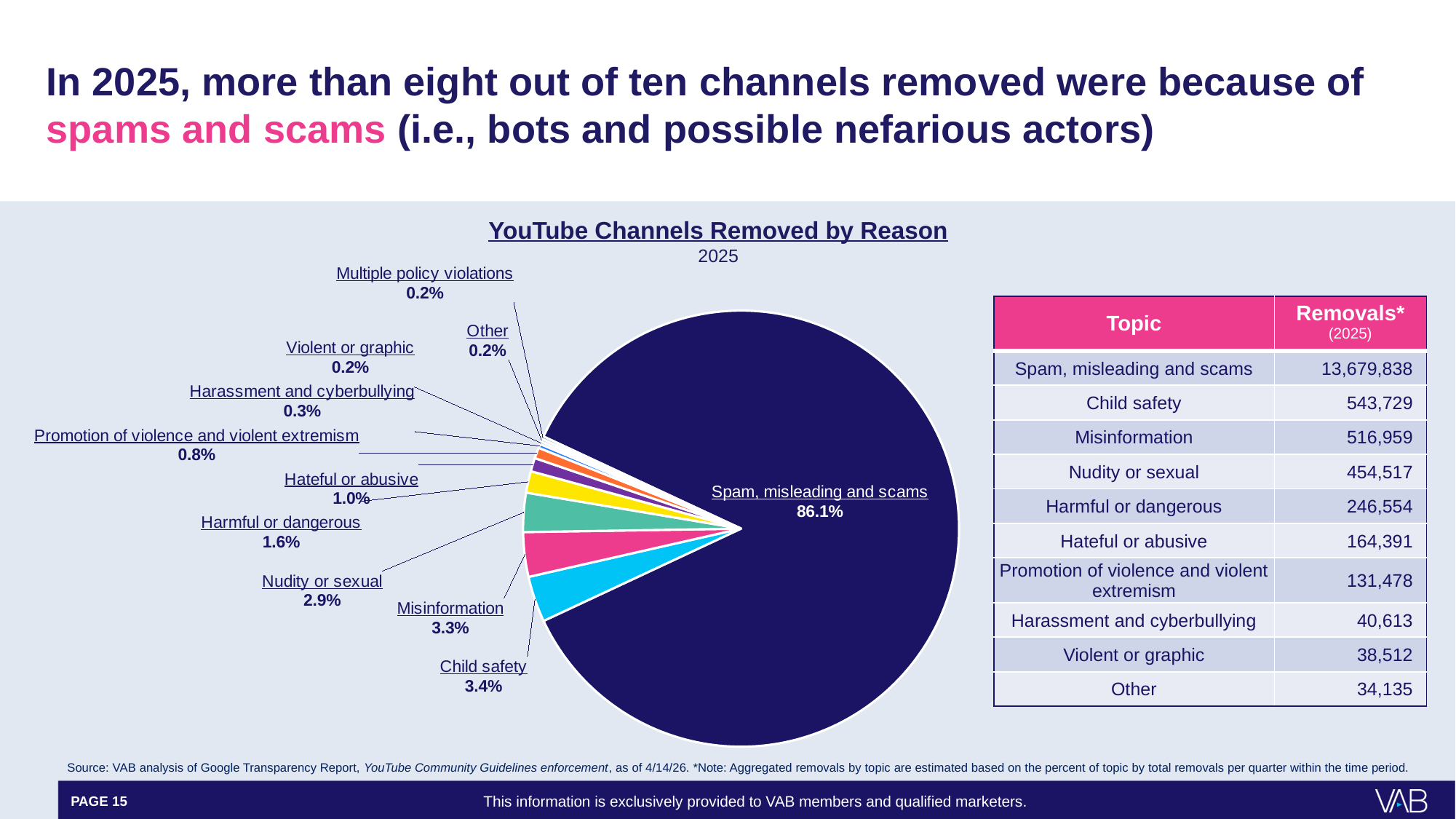
What is the difference in percentage points between Nudity or sexual and Harmful or dangerous in the pie chart? 1.3 percentage points What percentage does the pie chart show for Hateful or abusive? 1.0% What percentage does the pie chart show for Nudity or sexual? 2.9% What type of chart is shown on the slide? Pie chart How many slices does the pie chart have? 11 What year does the pie chart cover, according to its subtitle? 2025 What share of the pie chart is Spam, misleading and scams? 86.1% What is the title of the chart? YouTube Channels Removed by Reason Which slice is larger in the pie chart, Child safety or Misinformation? Child safety Which reason has the largest slice in the pie chart? Spam, misleading and scams What percentage does the pie chart show for Child safety? 3.4% What percentage does the pie chart show for Promotion of violence and violent extremism? 0.8%